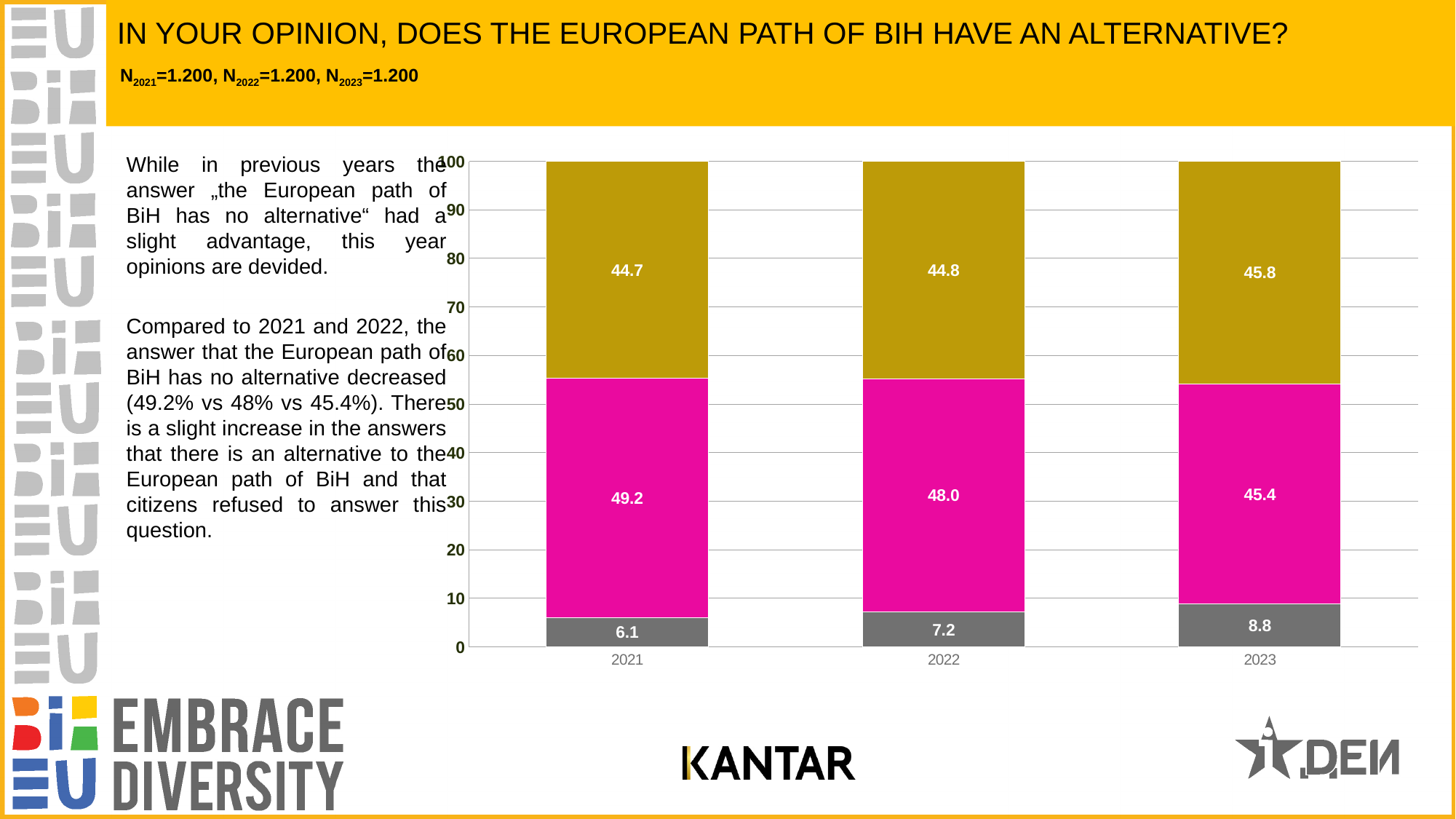
How many years are shown on the x axis of the chart? 3 What is the value of the gold top segment for 2022? 44.8 What kind of chart is shown on the slide? Stacked bar chart Does the grey bottom segment rise or fall from 2021 to 2023? Rise In which year is the grey bottom segment the largest? 2023 In 2023, which is larger: the gold top segment or the magenta middle segment? Gold top segment What is the difference between the magenta segment values for 2021 and 2023? 3.8 What is the value of the grey bottom segment for 2021? 6.1 What is the total of the stacked bar for 2022? 100.0 What is the title of the slide containing the chart? IN YOUR OPINION, DOES THE EUROPEAN PATH OF BIH HAVE AN ALTERNATIVE? In which year is the magenta middle segment the smallest? 2023 What is the value of the magenta middle segment for 2023? 45.4